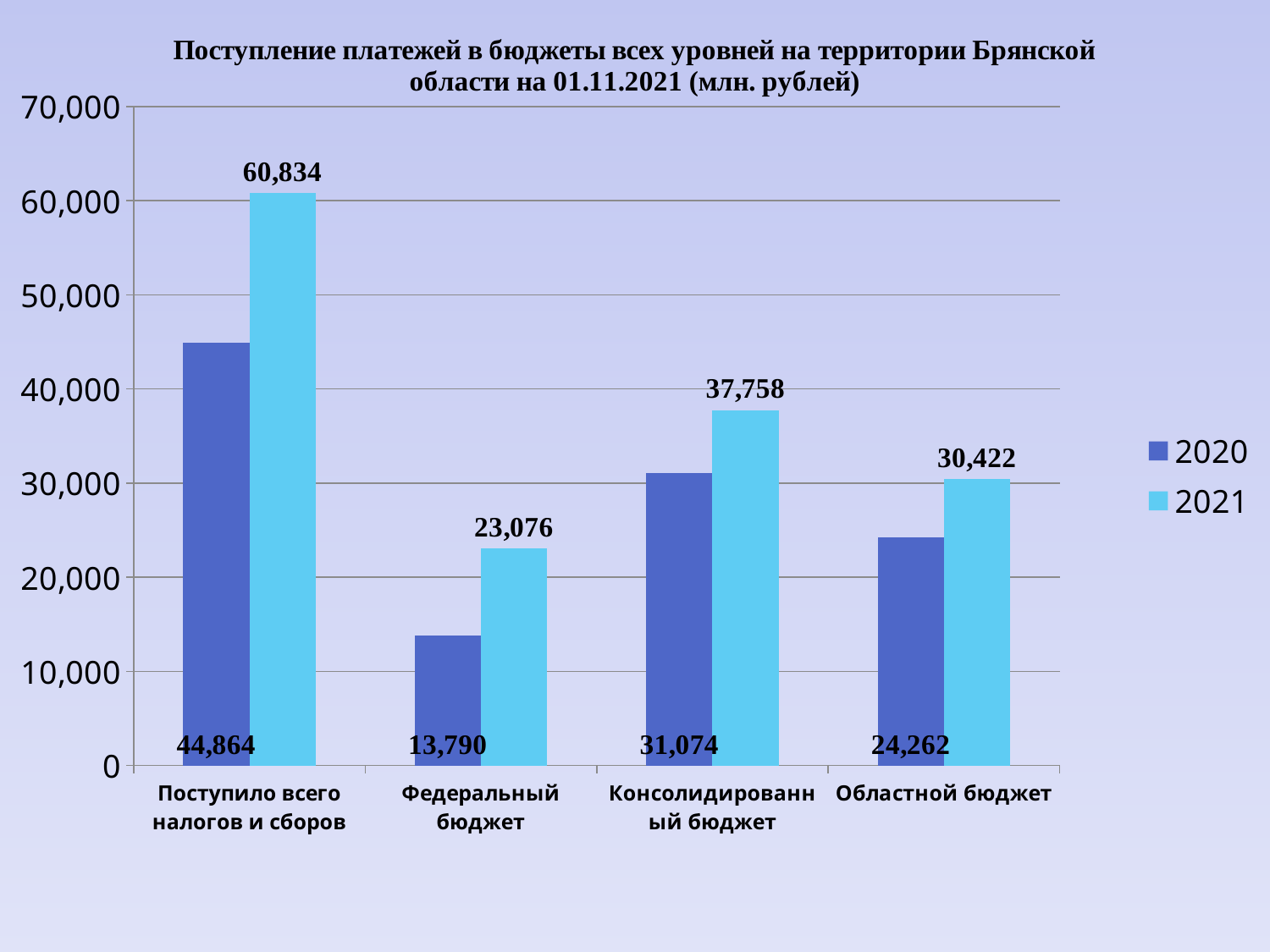
How many series does the legend list? 2 What is the difference between the 2021 and 2020 values for Федеральный бюджет? 9,286 What is the 2021 value for Консолидированный бюджет? 37,758 Which is larger for Областной бюджет: the 2020 value or the 2021 value? 2021 What is the 2020 value for Федеральный бюджет? 13,790 What is the 2020 value for Областной бюджет? 24,262 What is the 2021 value for Поступило всего налогов и сборов? 60,834 How many categories are shown on the x axis? 4 Which category has the lowest 2020 value? Федеральный бюджет What kind of chart is shown on the slide? Bar chart Which category has the highest 2021 value? Поступило всего налогов и сборов What is the difference between the 2021 and 2020 values for Поступило всего налогов и сборов? 15,970